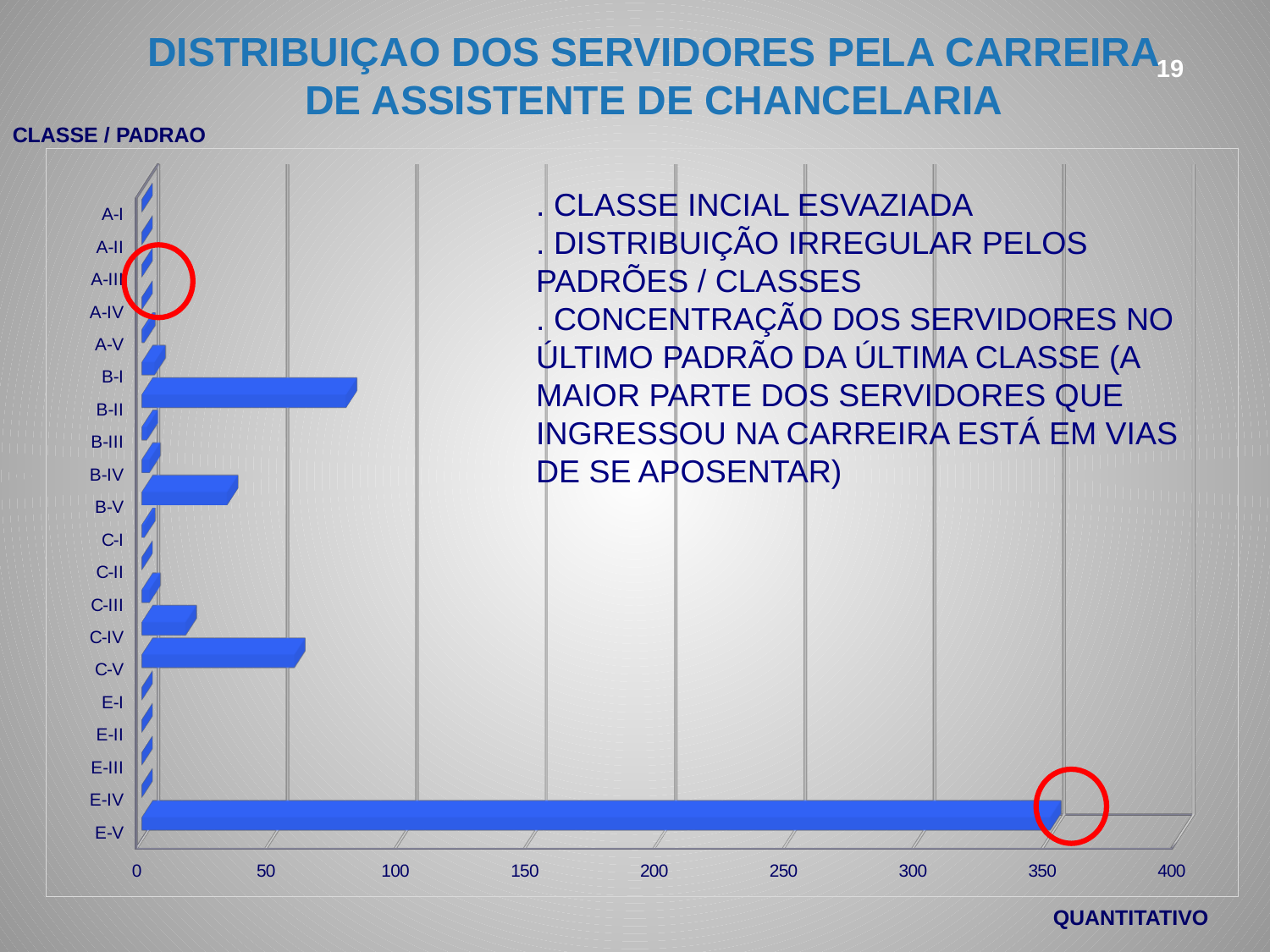
Is the value for C-IV greater or less than 50? less How many classe/padrão categories are listed on the vertical axis of the chart? 20 Is the value for E-V greater or less than 300? greater What is the label shown above the vertical axis of the chart? CLASSE / PADRAO What is the label of the horizontal axis of the chart? QUANTITATIVO Which category has the highest quantitativo in the chart? E-V Is the value for B-V greater or less than 50? less Which has a larger value, B-V or C-IV? B-V What kind of chart is shown on the slide? bar chart Which has a larger value, B-II or C-V? B-II